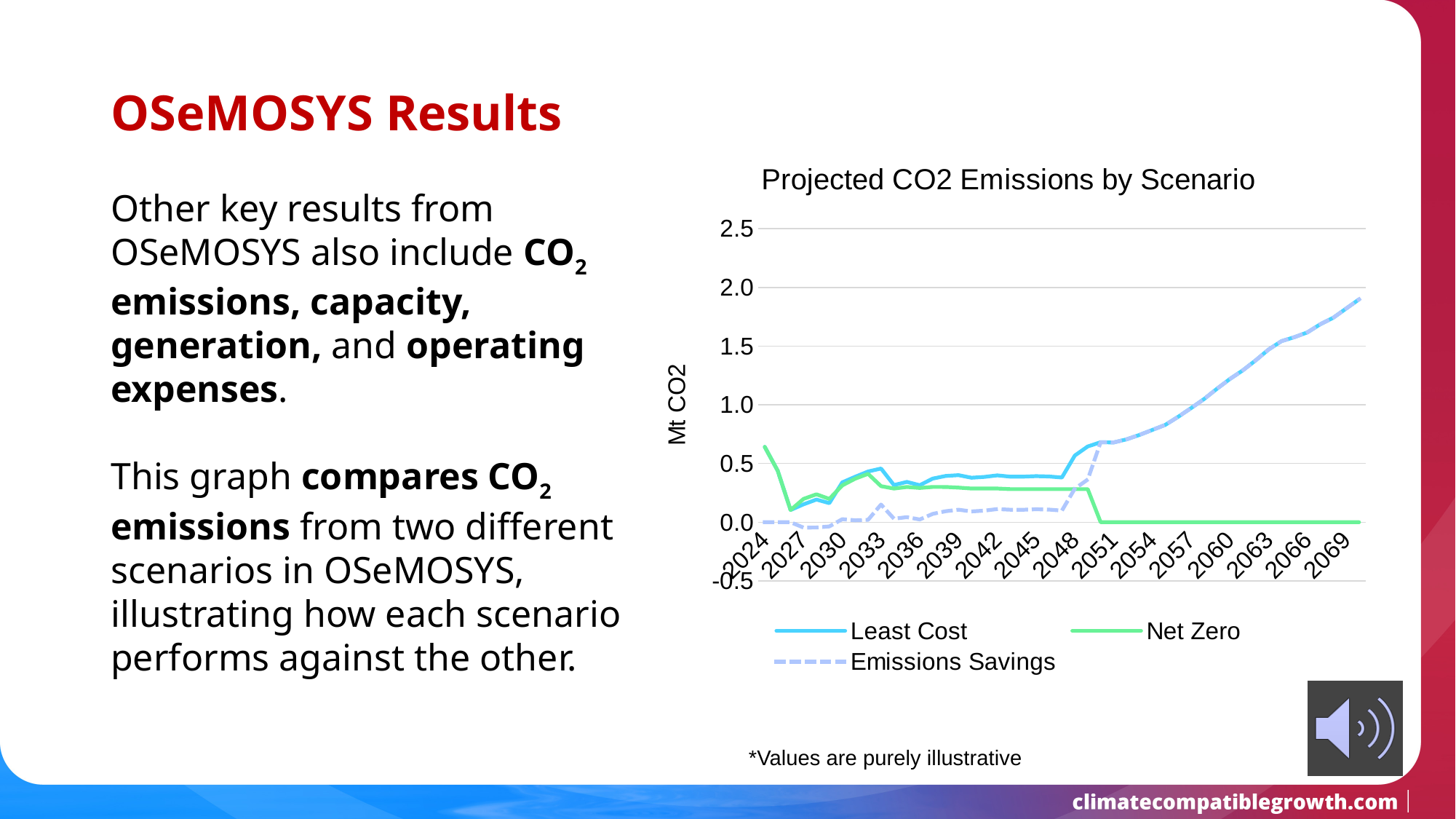
Is the Net Zero value in 2069 greater or less than 0.5? less What kind of chart is shown on the slide? line chart In 2060, which is larger: the Least Cost value or the Net Zero value? Least Cost Is the Emissions Savings value in 2030 greater or less than 0.5? less What is the label on the y axis of the chart? Mt CO2 Does the Least Cost series rise or fall between 2051 and 2069? rise Is the Least Cost value in 2060 greater or less than 1.0? greater Which series has the lowest value in 2069? Net Zero How many series does the legend of the chart list? 3 What is the title of the chart? Projected CO2 Emissions by Scenario